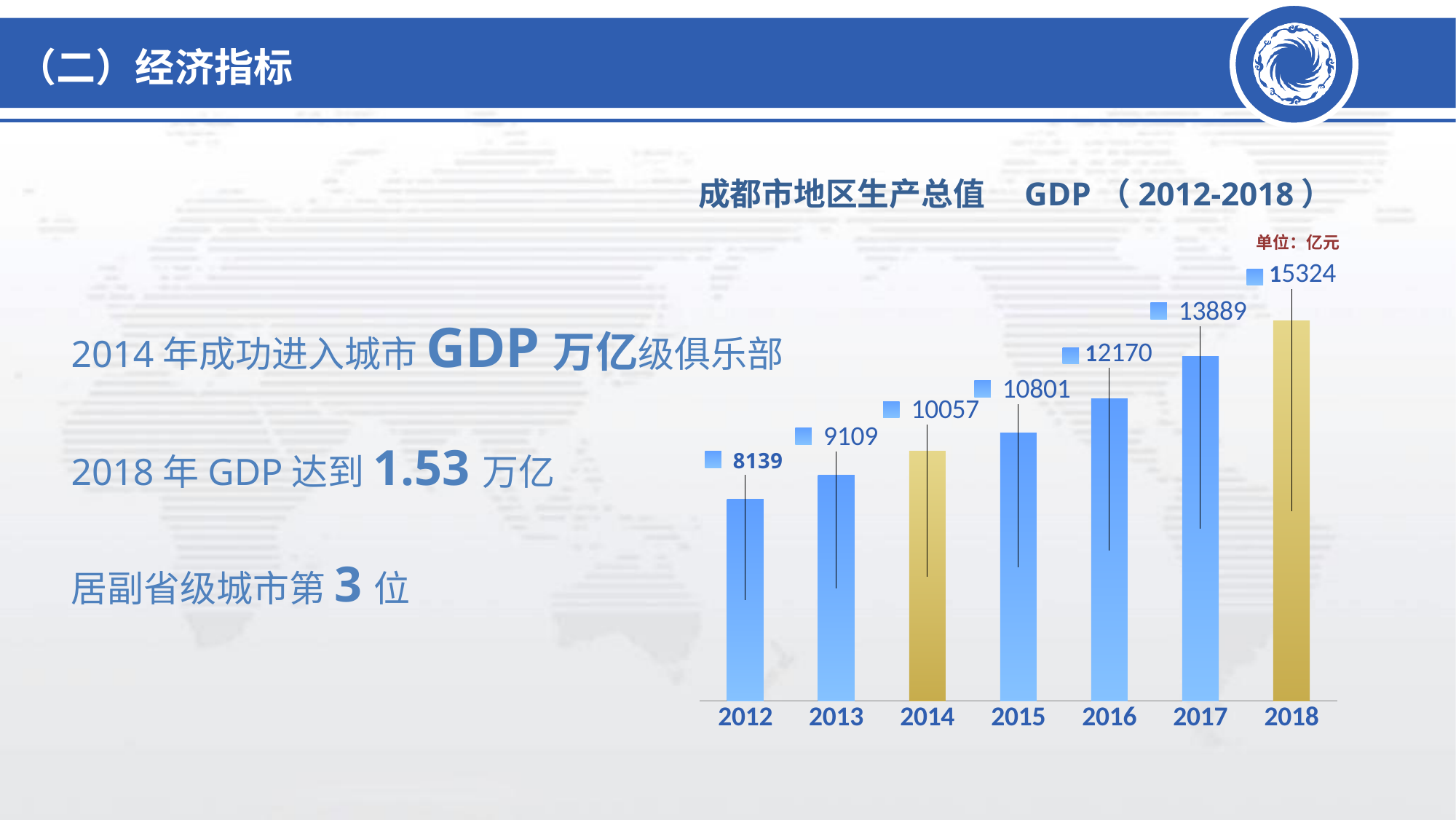
What is the difference between the GDP values for 2018 and 2017? 1435 What is the GDP value shown for 2016? 12170 How many years are plotted in the chart? 7 Which year has the lowest GDP value in the chart? 2012 What is the difference between the GDP values for 2015 and 2014? 744 Which year has the highest GDP value in the chart? 2018 What kind of chart is shown on the slide? Bar chart What is the GDP value shown for 2012? 8139 Do the GDP values rise or fall from 2012 to 2018? Rise Which year has a larger GDP value, 2013 or 2015? 2015 What is the GDP value shown for 2014? 10057 What is the GDP value shown for 2018? 15324